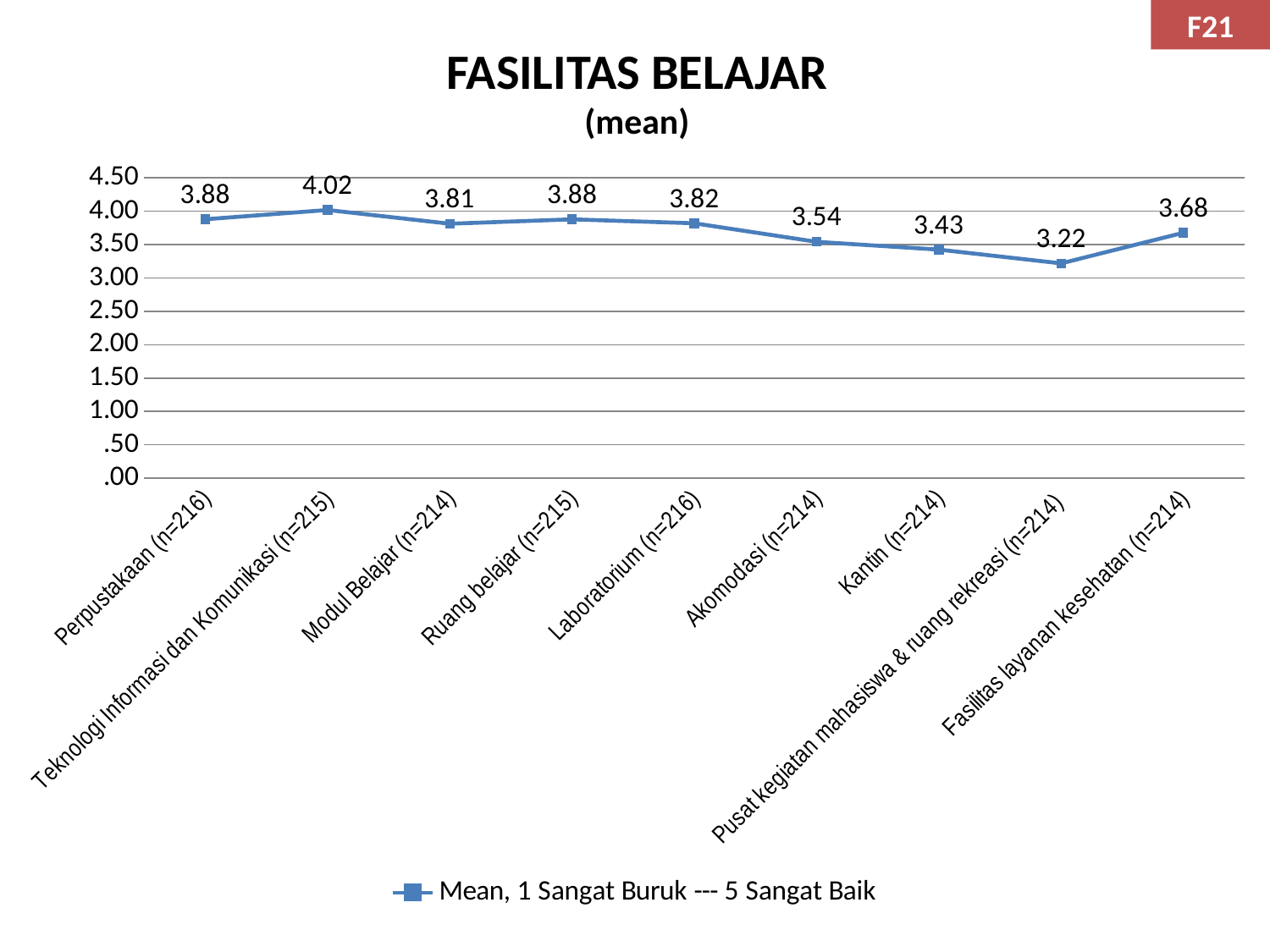
Is the mean value for Modul Belajar (n=214) greater or less than 3.50? greater How many series does the legend list? 1 What is the legend entry for the plotted series? Mean, 1 Sangat Buruk --- 5 Sangat Baik What is the mean value for Perpustakaan (n=216)? 3.88 What is the difference between the mean for Teknologi Informasi dan Komunikasi (n=215) and the mean for Pusat kegiatan mahasiswa & ruang rekreasi (n=214)? 0.80 What is the mean value for Kantin (n=214)? 3.43 What kind of chart is shown on the slide? line chart How many categories are plotted on the chart? 9 What is the mean value for Fasilitas layanan kesehatan (n=214)? 3.68 Which category has the lowest mean value? Pusat kegiatan mahasiswa & ruang rekreasi (n=214) Which category has the highest mean value? Teknologi Informasi dan Komunikasi (n=215) Which has a higher mean value, Akomodasi (n=214) or Laboratorium (n=216)? Laboratorium (n=216)